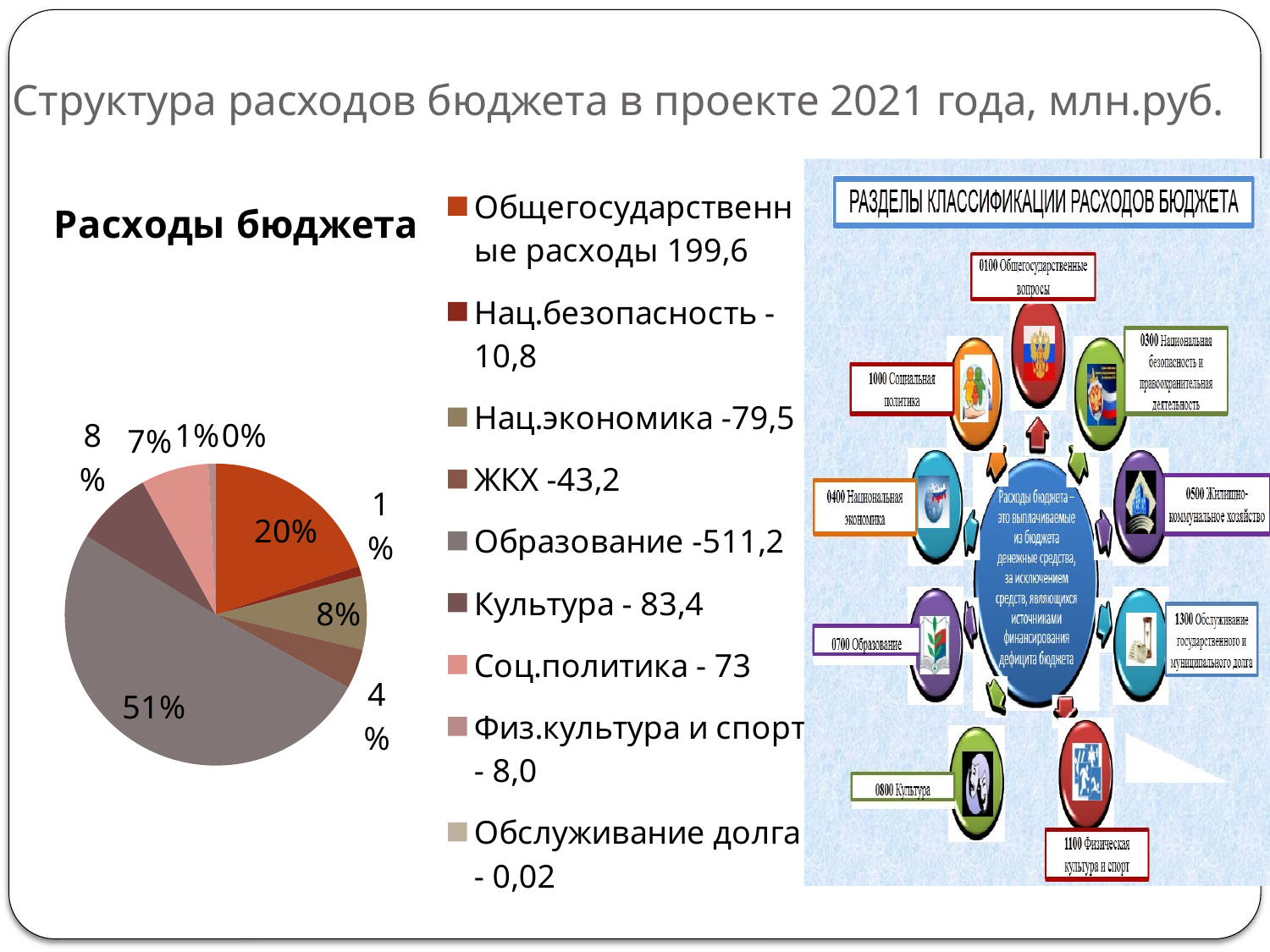
How many entries does the legend of the pie chart list? 9 What share of the pie does Образование take? 51% What is the difference in percentage points between the Образование slice and the Общегосударственные расходы slice? 31% What value is shown in the legend for Образование? 511,2 Which slice is larger: Образование or Общегосударственные расходы? Образование What share of the pie does Соц.политика take? 7% Which category has the smallest slice of the pie? Обслуживание долга What kind of chart is shown on the slide? pie chart What share of the pie does ЖКХ take? 4% Which category has the largest slice of the pie? Образование What is the title of the pie chart? Расходы бюджета